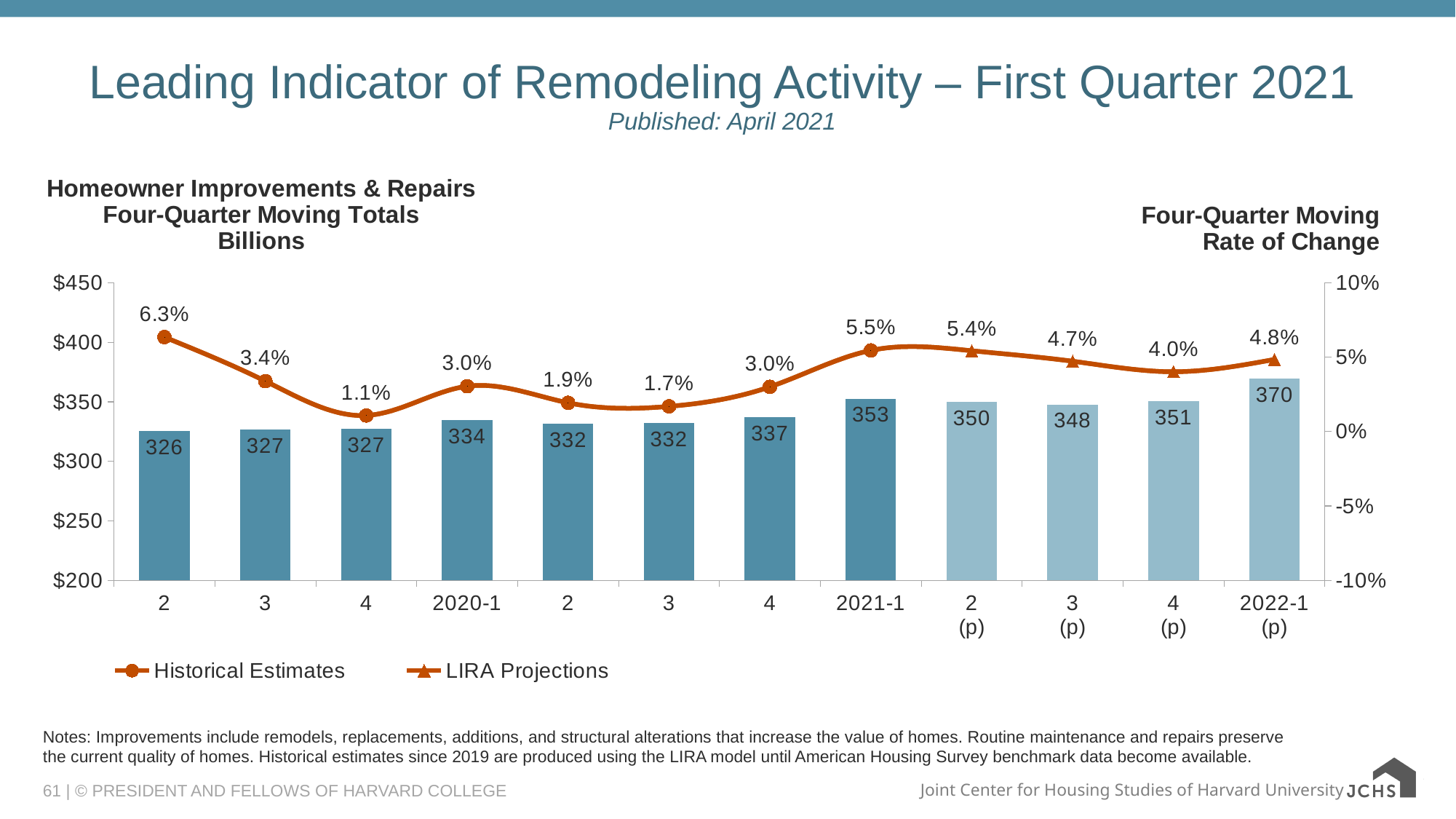
Which quarter has the highest four-quarter moving total bar? 2022-1 (p) What is the highest four-quarter moving rate of change shown on the line? 6.3% How many series does the legend list? 2 Which is larger, the four-quarter moving total for 2021-1 or for 2020-1? 2021-1 What is the four-quarter moving total (in billions) for 2021-1? 353 What is the difference in four-quarter moving totals between 2022-1 (p) and 2021-1? 17 Is the four-quarter moving total for 2022-1 (p) greater or less than $350? greater Which quarter has the lowest four-quarter moving rate of change on the line? 4 (the quarter before 2020-1) What is the four-quarter moving rate of change for 2022-1 (p)? 4.8% What are the two series named in the legend? Historical Estimates and LIRA Projections What is the four-quarter moving total (in billions) for 2020-1? 334 How many quarters are shown on the x axis? 12